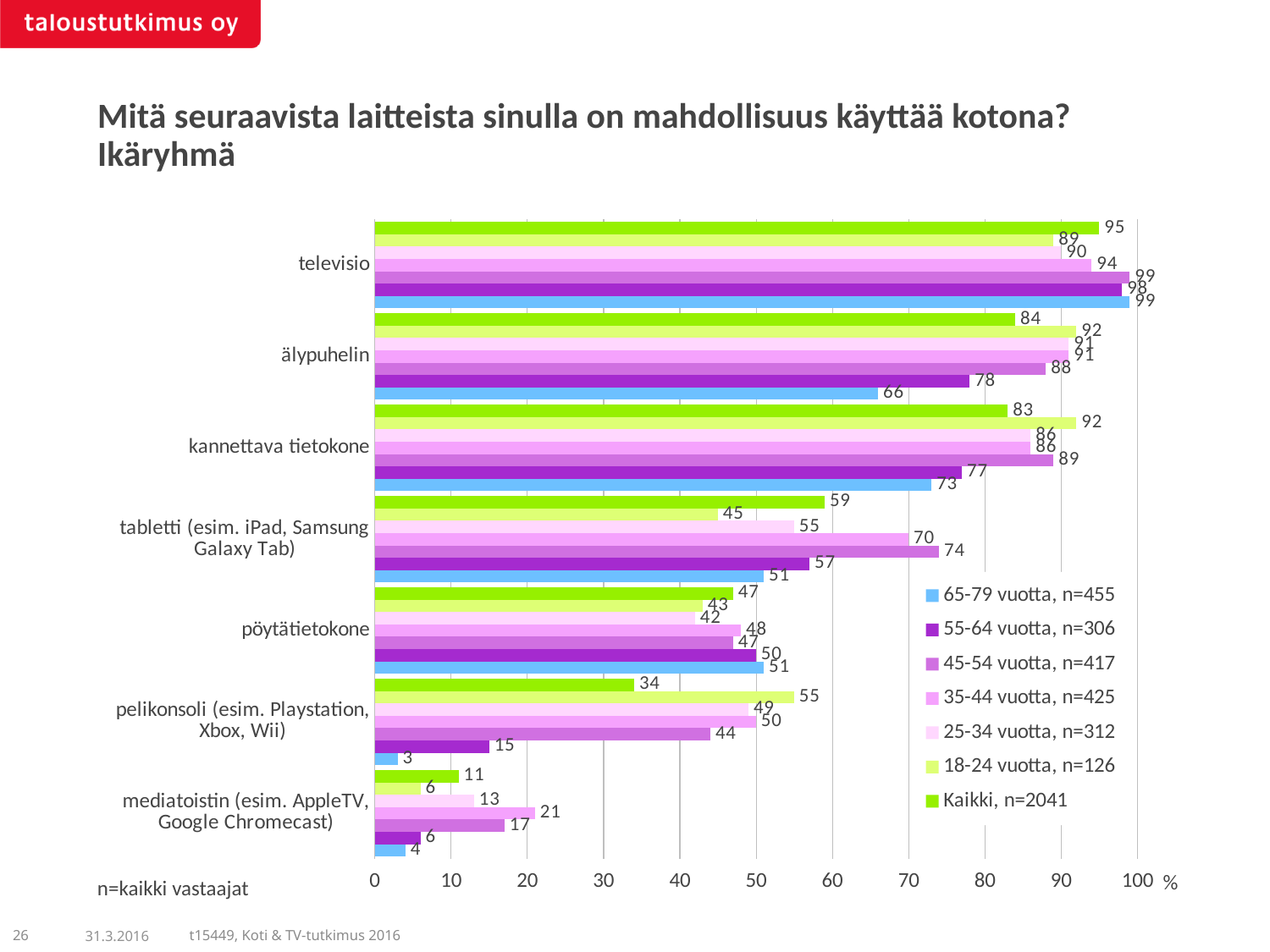
For tabletti (esim. iPad, Samsung Galaxy Tab), which is larger: the value for '45-54 vuotta, n=417' or for '18-24 vuotta, n=126'? 45-54 vuotta, n=417 How many series does the legend list? 7 What is the difference between the '18-24 vuotta, n=126' and '65-79 vuotta, n=455' values for pelikonsoli (esim. Playstation, Xbox, Wii)? 52 Which device category has the lowest value for 'Kaikki, n=2041'? mediatoistin (esim. AppleTV, Google Chromecast) What unit is shown at the end of the horizontal axis? % What is the value for '35-44 vuotta, n=425' for mediatoistin (esim. AppleTV, Google Chromecast)? 21 What is the value for 'Kaikki, n=2041' for televisio? 95 How many device categories are shown on the chart? 7 Which device category has the highest value for 'Kaikki, n=2041'? televisio What is the value for '65-79 vuotta, n=455' for älypuhelin? 66 What is the value for '18-24 vuotta, n=126' for pelikonsoli (esim. Playstation, Xbox, Wii)? 55 What kind of chart is shown on the slide? bar chart